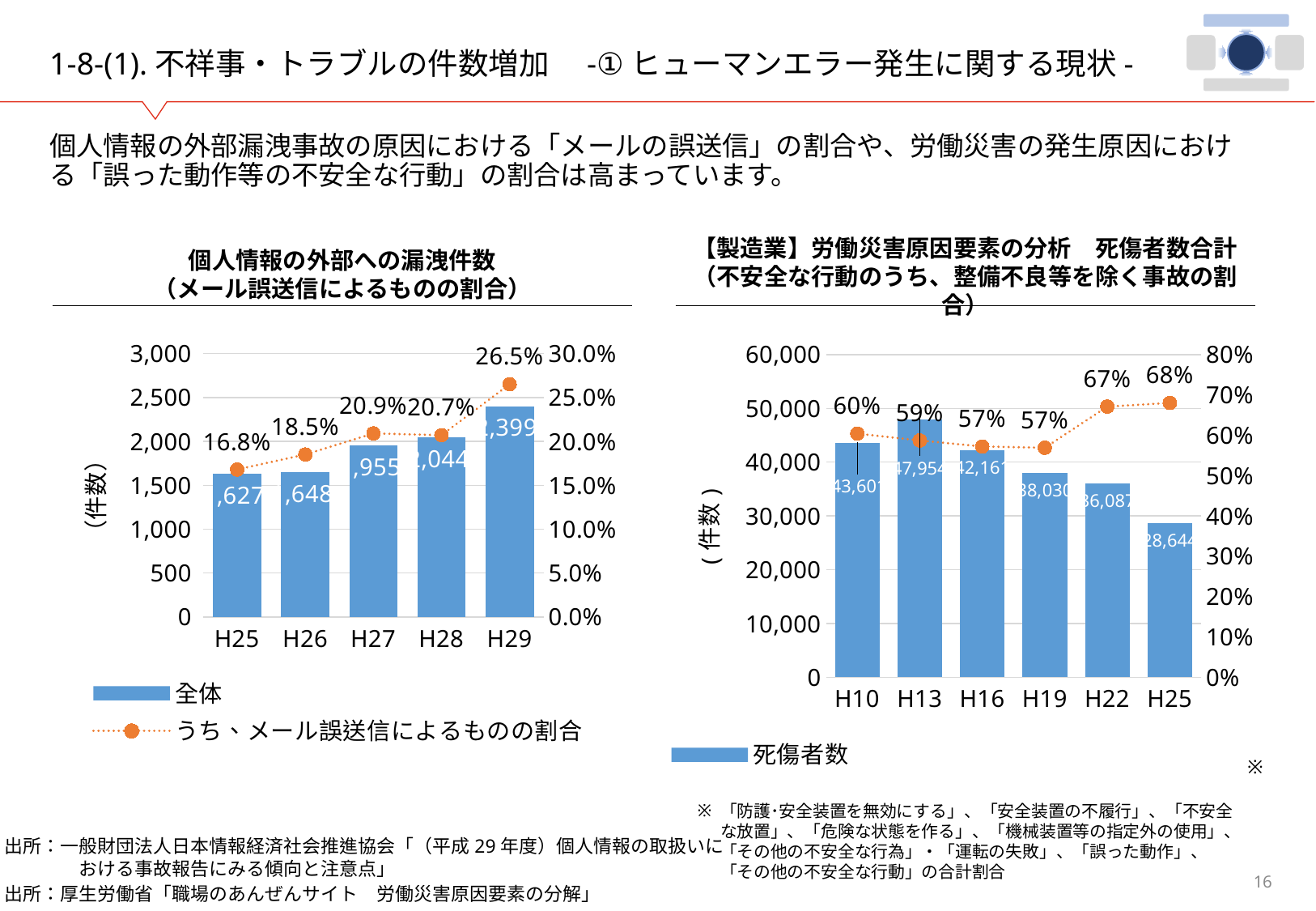
In the left chart (個人情報の外部への漏洩件数), by how many percentage points does the mis-sent email share in H29 exceed that in H25? 9.7 percentage points In the left chart (個人情報の外部への漏洩件数), how many years are shown on the x axis? 5 In the right chart (【製造業】労働災害原因要素の分析), what is the difference in casualties between H13 and H25? 19,310 In the right chart (【製造業】労働災害原因要素の分析), what is the percentage shown for H25? 68% In the left chart (個人情報の外部への漏洩件数), what is the percentage of leaks due to mis-sent email in H29? 26.5% In the left chart (個人情報の外部への漏洩件数), how many series does the legend list? 2 In the right chart (【製造業】労働災害原因要素の分析), do the casualty bars rise or fall from H13 to H25? fall In the right chart (【製造業】労働災害原因要素の分析), what is the number of casualties (死傷者数) in H25? 28,644 In the left chart (個人情報の外部への漏洩件数), which year has the highest percentage of leaks due to mis-sent email? H29 In the right chart (【製造業】労働災害原因要素の分析), which year has the highest number of casualties? H13 In the left chart (個人情報の外部への漏洩件数), is the total number of leaks (全体) in H29 greater or less than 2,000? greater In the left chart (個人情報の外部への漏洩件数), what is the percentage of leaks due to mis-sent email in H25? 16.8%